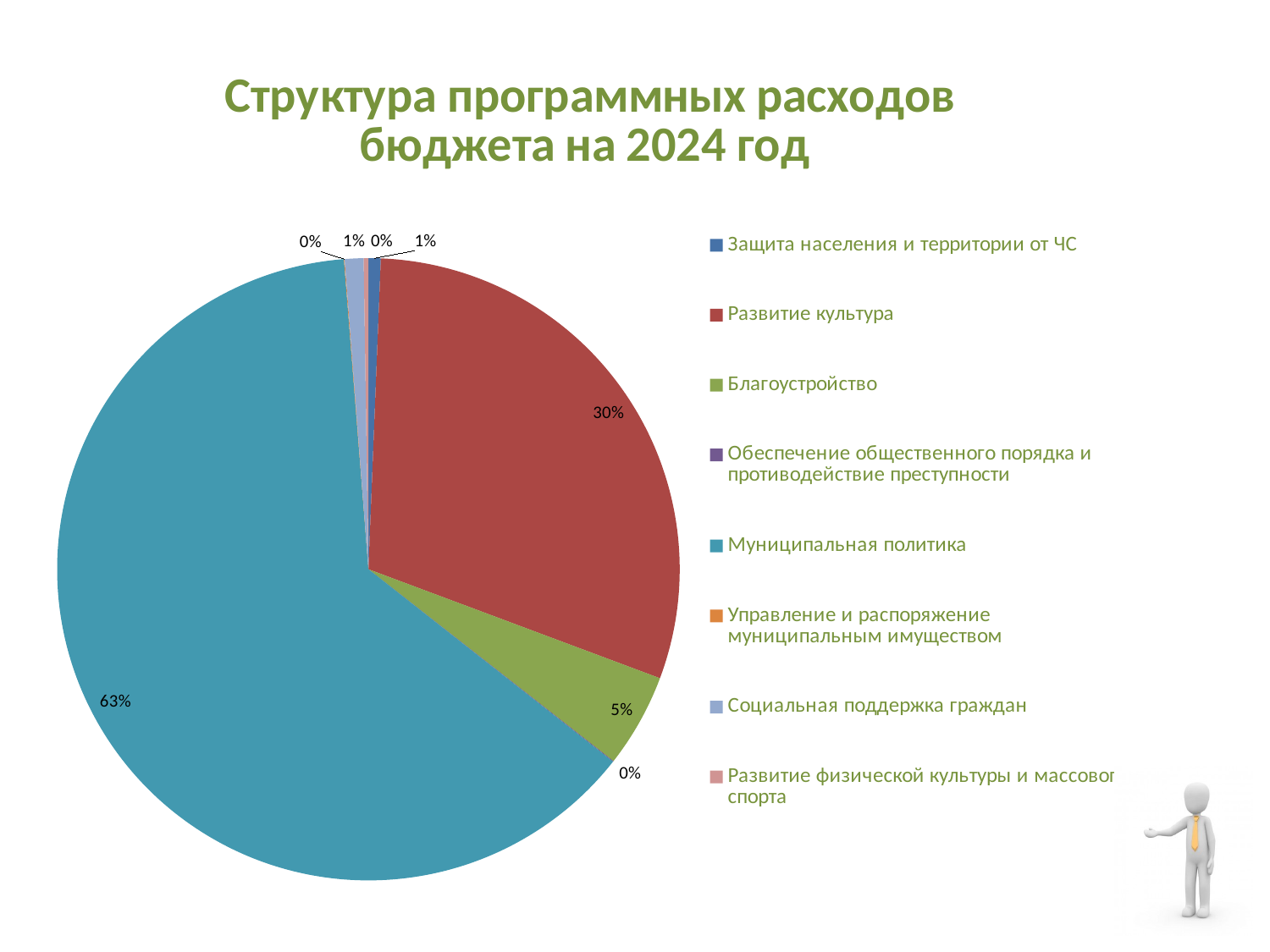
What is the title of the chart? Структура программных расходов бюджета на 2024 год What share of the pie does Благоустройство take? 5% What kind of chart is shown on the slide? pie chart What share of the pie does Муниципальная политика take? 63% What is the combined share of Муниципальная политика and Развитие культура? 93% What share of the pie does Социальная поддержка граждан take? 1% Which category has the largest share of the pie? Муниципальная политика What colour is the slice for Муниципальная политика? teal How many entries does the legend list? 8 Which is larger, the share for Развитие культура or the share for Благоустройство? Развитие культура What is the difference in percentage points between Муниципальная политика and Развитие культура? 33